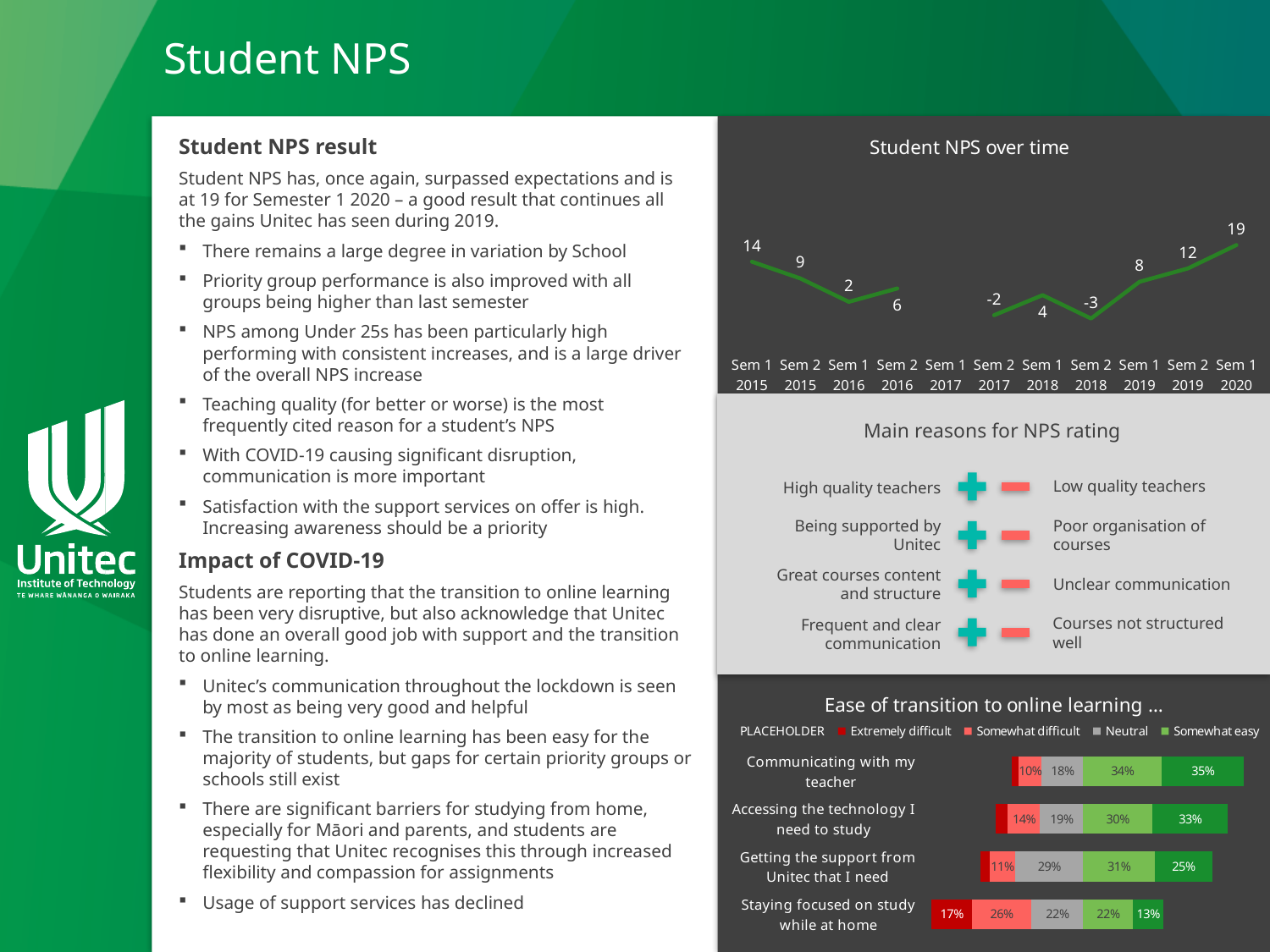
In the 'Student NPS over time' chart, what is the difference between the Student NPS for Sem 1 2020 and Sem 2 2019? 7 In the 'Student NPS over time' chart, which semester has the lowest Student NPS? Sem 2 2018 In the 'Ease of transition to online learning' chart, what percentage of students were Neutral about 'Communicating with my teacher'? 18% In the 'Student NPS over time' chart, which semester has the highest Student NPS? Sem 1 2020 In the 'Student NPS over time' chart, what is the Student NPS for Sem 1 2020? 19 In the 'Student NPS over time' chart, what is the Student NPS for Sem 1 2015? 14 In the 'Student NPS over time' chart, is the Student NPS higher in Sem 2 2015 or Sem 1 2016? Sem 2 2015 In the 'Student NPS over time' chart, does the Student NPS rise or fall from Sem 2 2018 to Sem 1 2020? Rise What type of chart is 'Student NPS over time'? Line chart What type of chart is 'Ease of transition to online learning'? Stacked bar chart In the 'Ease of transition to online learning' chart, what percentage of students found 'Staying focused on study while at home' Extremely difficult? 17% In the 'Student NPS over time' chart, what is the Student NPS for Sem 2 2018? -3